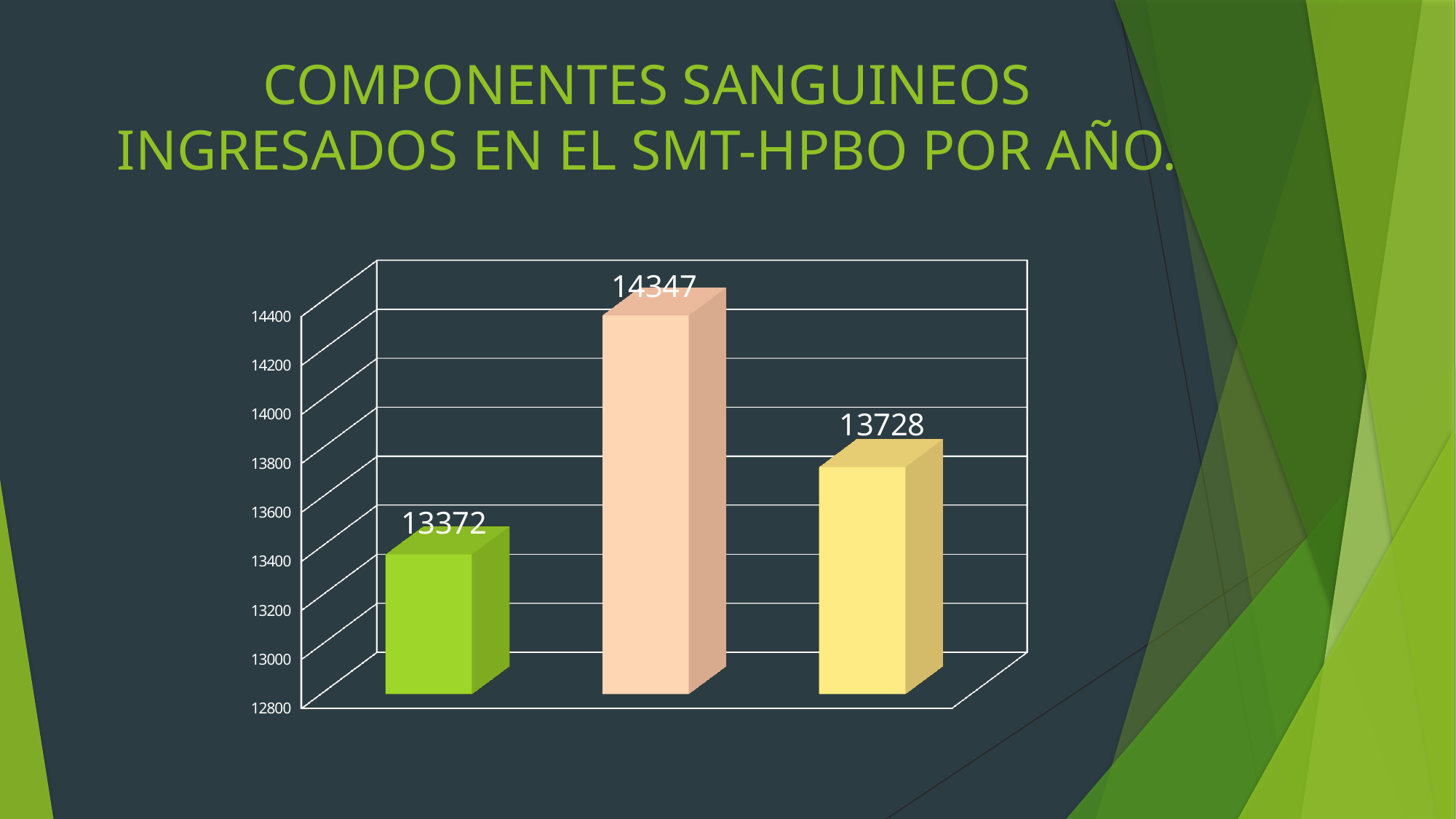
Is the value of the middle bar greater or less than 14000? greater What is the value shown on the middle bar? 14347 Which bar has the lowest value: the first, second or third? the first (leftmost) bar Which is larger, the value of the rightmost bar or the value of the leftmost bar? the rightmost bar What kind of chart is shown on the slide? bar chart What is the difference between the rightmost bar's value and the leftmost bar's value? 356 Which bar has the highest value: the first, second or third? the second (middle) bar What is the difference between the middle bar's value and the leftmost bar's value? 975 What is the value shown on the third (rightmost) bar? 13728 What is the value shown on the first (leftmost) bar? 13372 How many bars are plotted in the chart? 3 What is the title of the slide containing the chart? COMPONENTES SANGUINEOS INGRESADOS EN EL SMT-HPBO POR AÑO.